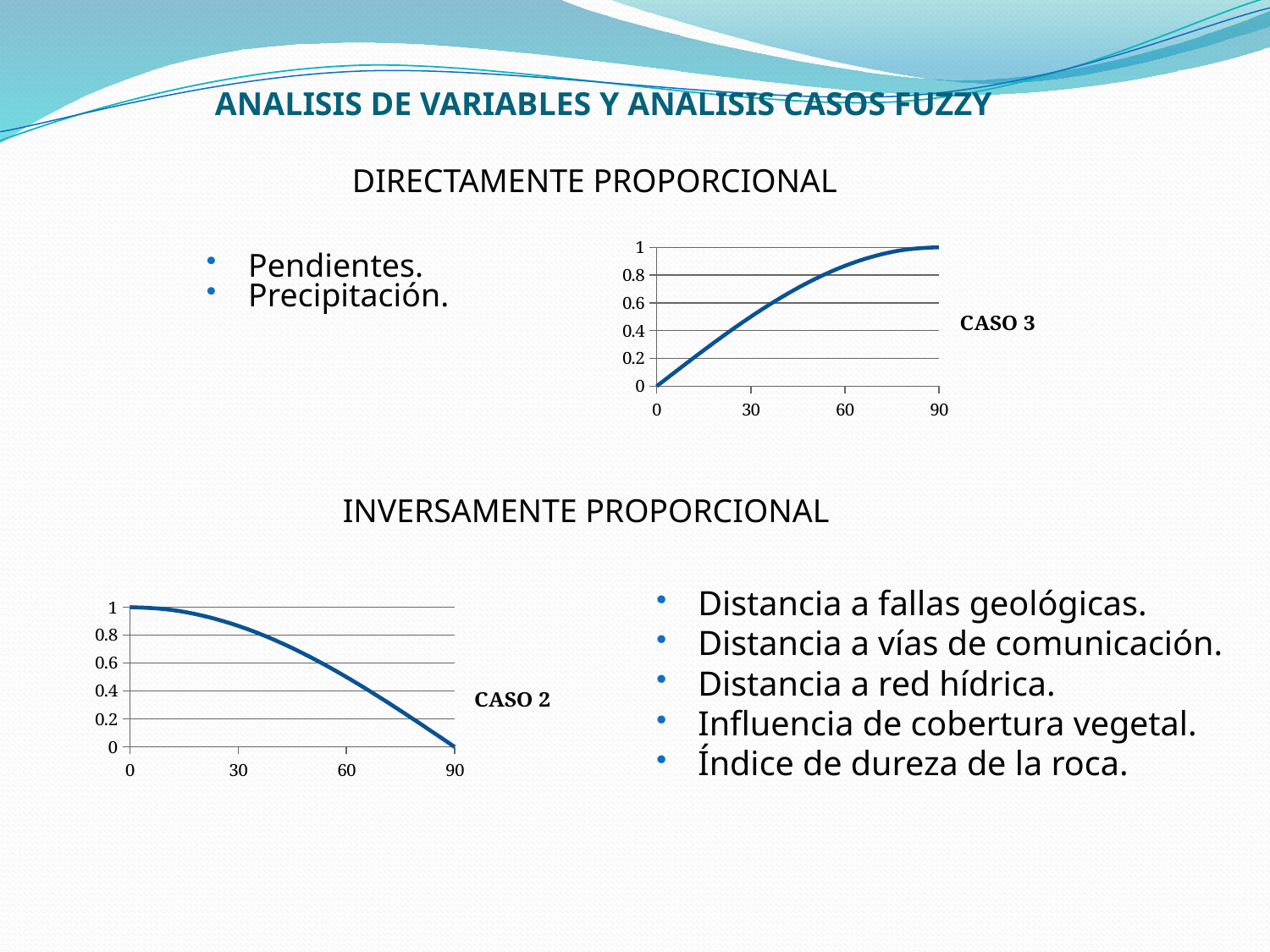
In the CASO 3 chart, what is the value of the line at x = 90? 1 In the CASO 2 chart, is the value at x = 60 greater or less than 0.8? less What kind of chart is the CASO 3 chart at the top right of the slide? line chart In the CASO 2 chart, what is the value of the line at x = 90? 0 In the CASO 2 chart, what is the value of the line at x = 0? 1 In the CASO 3 chart, is the value at x = 60 greater or less than 0.6? greater In the CASO 3 chart, do the values rise or fall as x goes from 0 to 90? rise In the CASO 2 chart, do the values rise or fall as x goes from 0 to 90? fall In the CASO 3 chart, what is the value of the line at x = 0? 0 What kind of chart is the CASO 2 chart at the bottom left of the slide? line chart